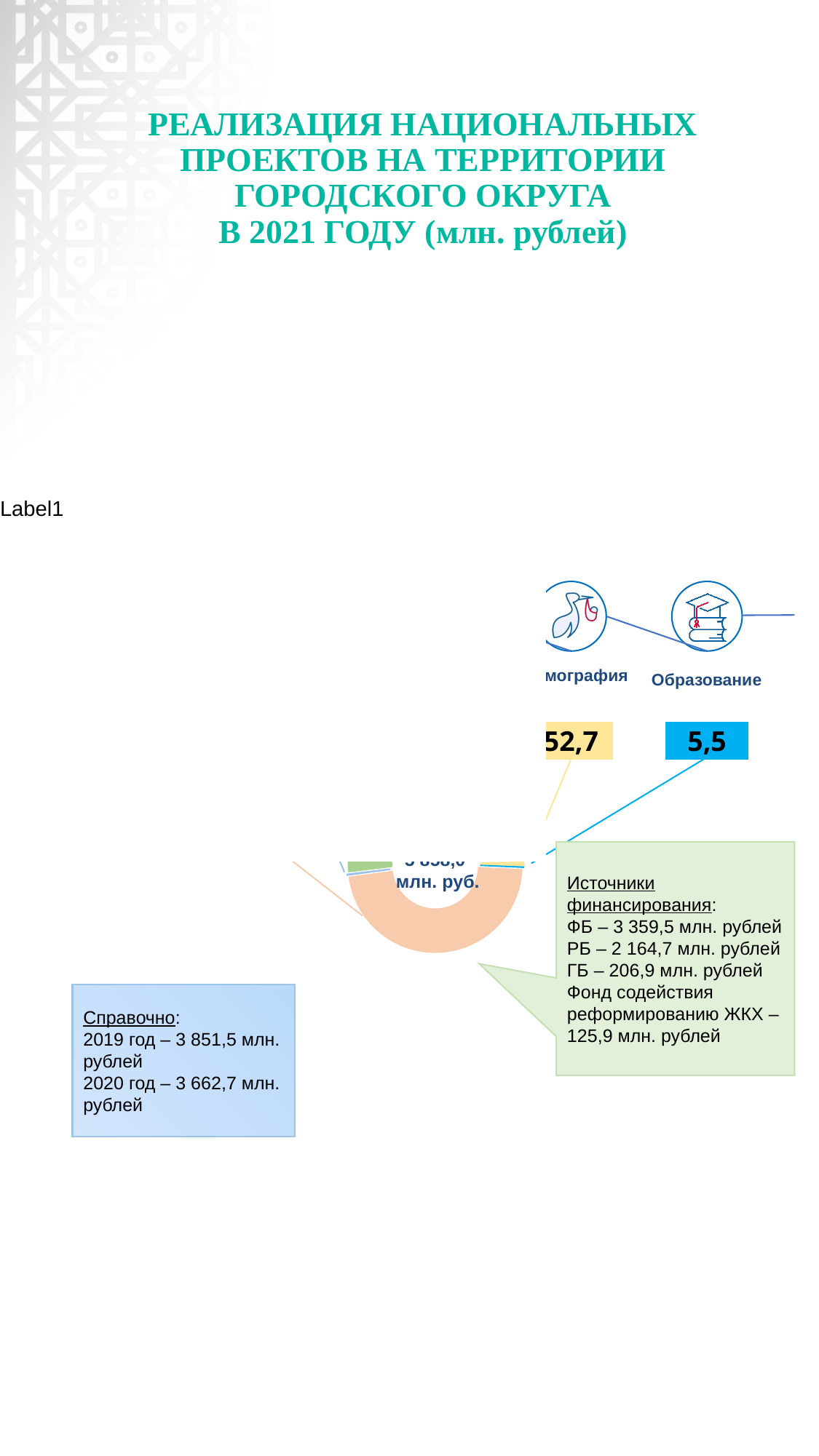
What colour is the data label box for Образование on the chart? blue What kind of chart is shown on the slide? doughnut chart Which category on the chart is labelled with a graduation cap and books icon? Образование What value is shown for Образование on the chart? 5,5